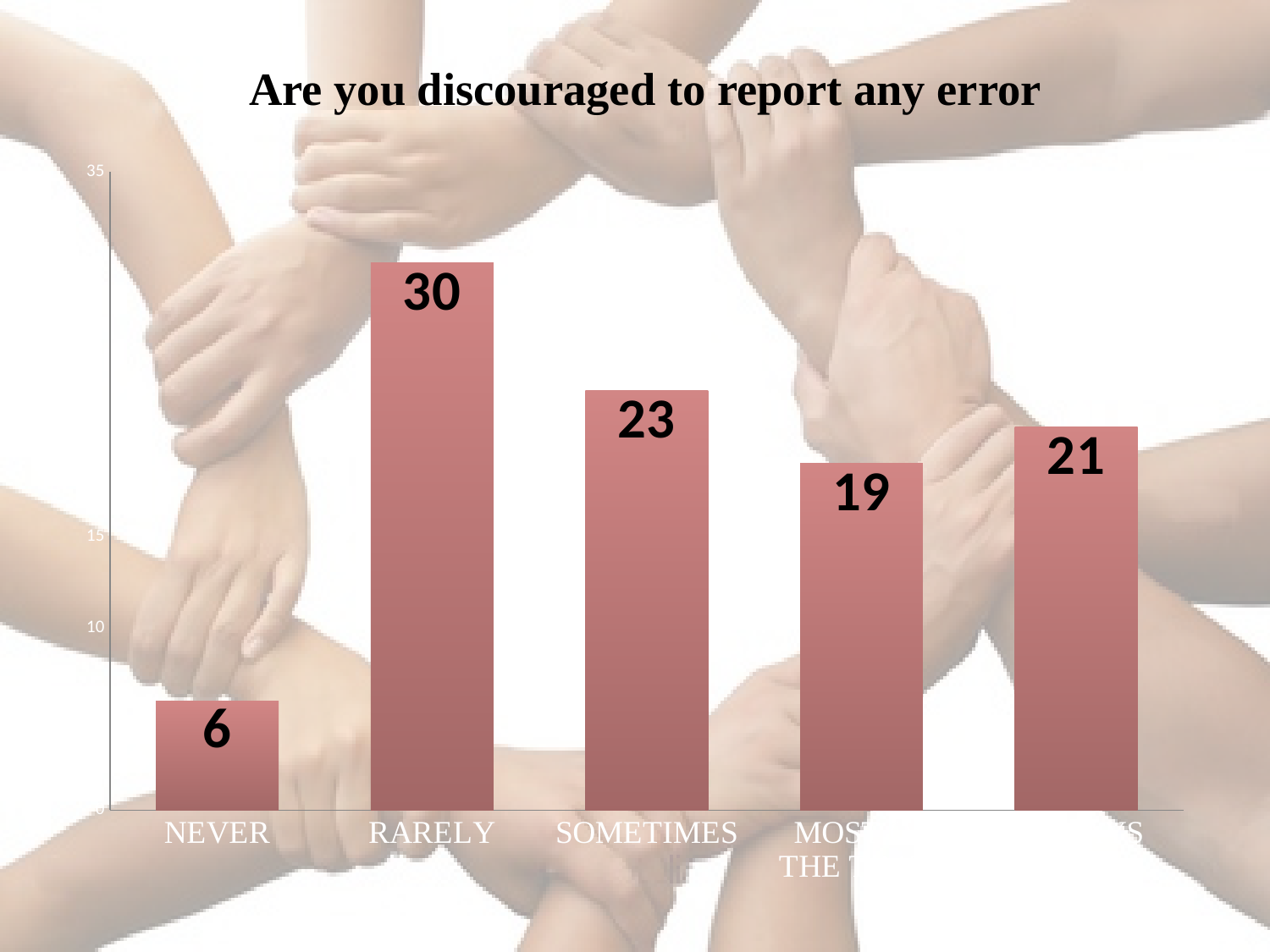
Which category has the highest value? RARELY Which category has the lowest value? NEVER What is the difference between the values for SOMETIMES and NEVER? 17 What is the difference between the values for RARELY and SOMETIMES? 7 What kind of chart is shown on the slide? bar chart What is the value for RARELY? 30 What is the value for NEVER? 6 Which is larger, the value for RARELY or the value for SOMETIMES? RARELY Is the value for NEVER greater or less than 10? less What is the title of the chart? Are you discouraged to report any error What is the value for SOMETIMES? 23 How many bars are shown in the chart? 5